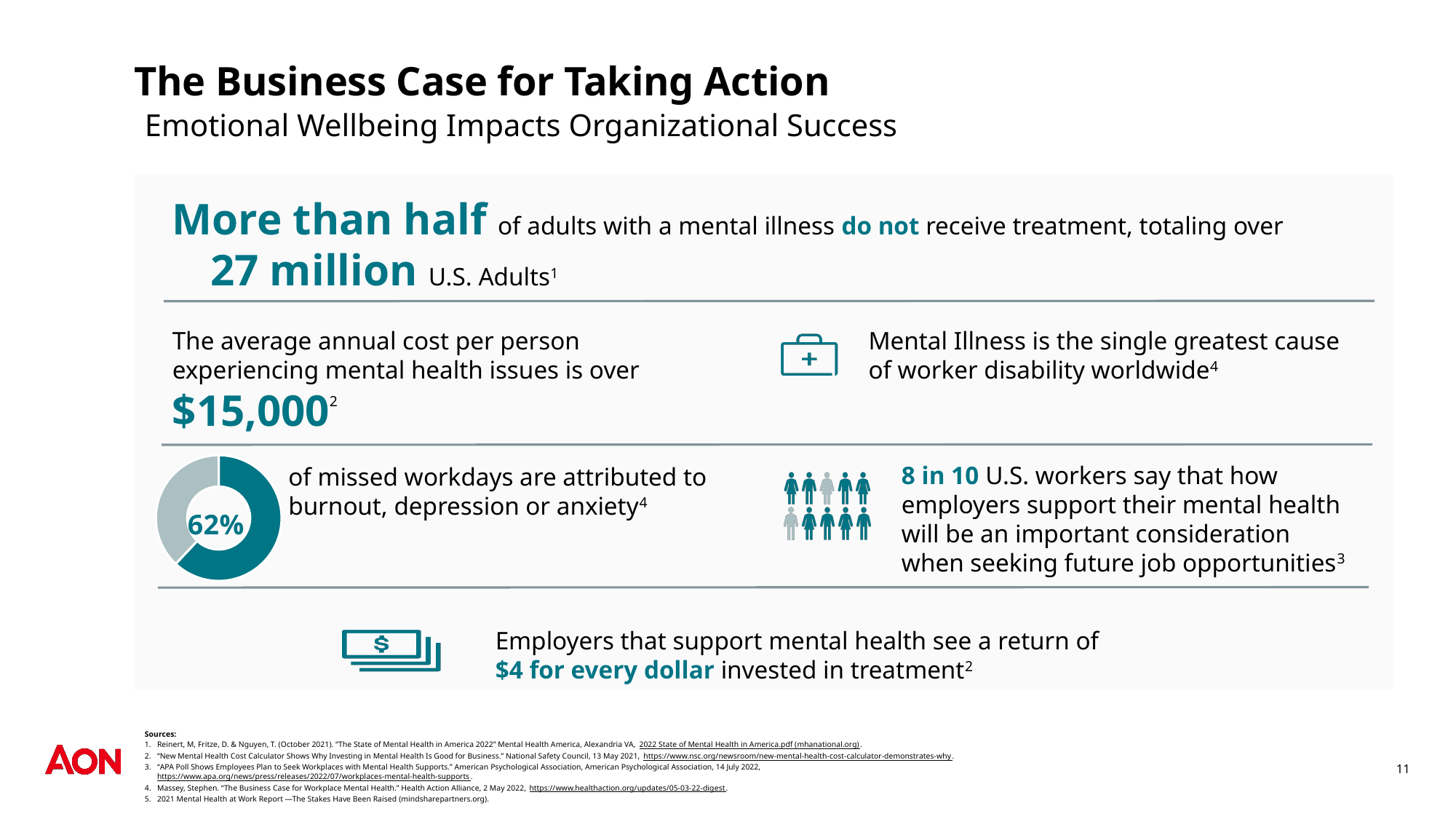
In the donut chart, what share of missed workdays is not attributed to burnout, depression or anxiety? 38% In the donut chart, what percentage of missed workdays are attributed to burnout, depression or anxiety? 62% How many slices does the donut chart have? 2 In the pictogram of workers, how many person icons are grey rather than teal? 2 In the donut chart, is the teal slice larger or smaller than the grey slice? larger In the pictogram of workers next to the '8 in 10' statistic, how many person icons are shown in total? 10 What kind of chart is shown next to the text about missed workdays? donut chart Where is the 62% label placed in the donut chart? in the centre of the donut In the pictogram of workers, how many person icons are highlighted in teal? 8 What colour is the slice representing the 62% in the donut chart? teal Is the value shown in the donut chart greater or less than 50%? greater